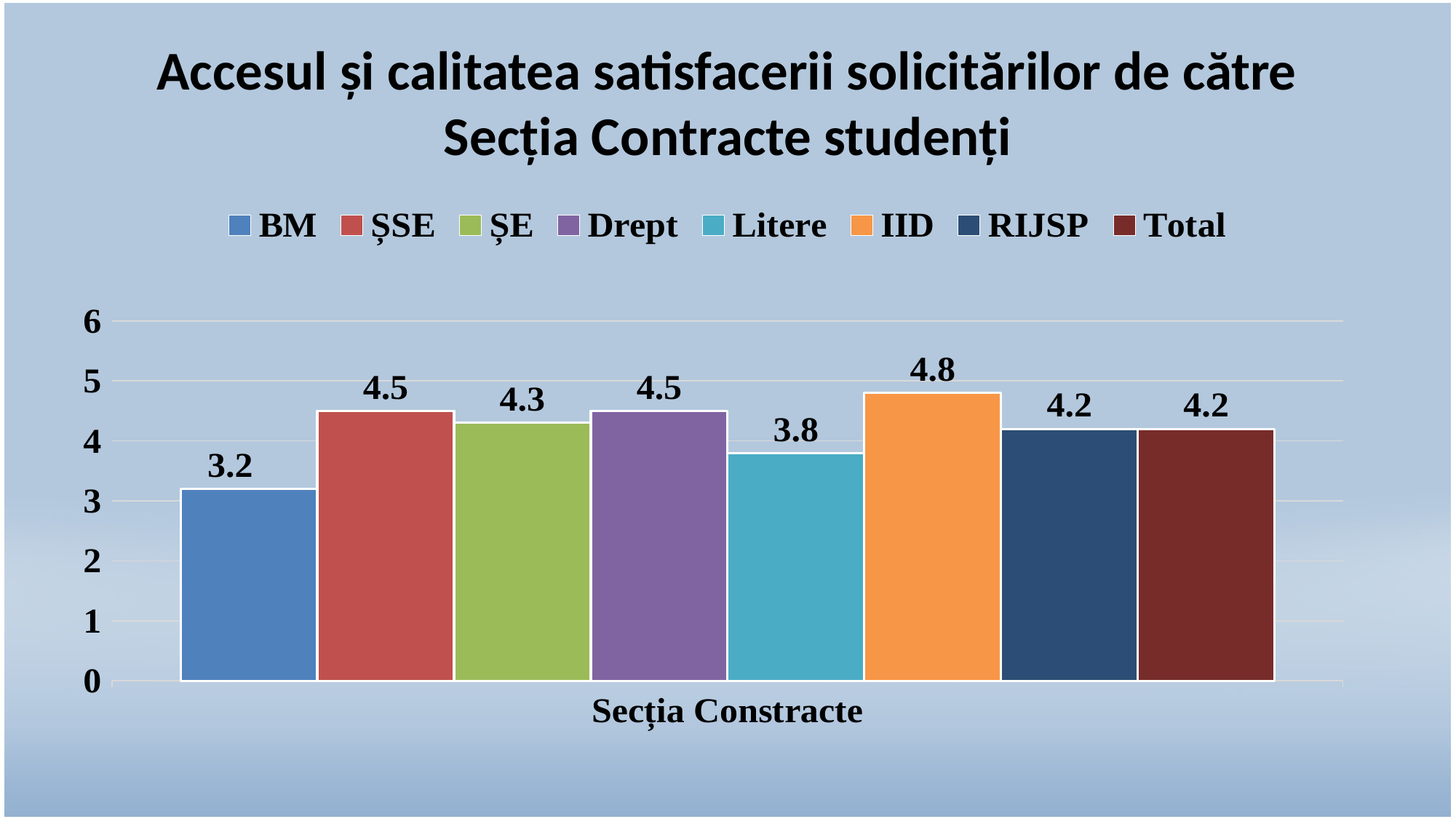
What is the value for IID? 4.8 Which series has the lowest value? BM What is the label on the x axis of the chart? Secția Constracte What is the value for Litere? 3.8 Which series has the highest value? IID What kind of chart is shown on the slide? Bar chart What is the difference between the values for IID and BM? 1.6 What is the value for BM? 3.2 Is the value for RIJSP greater or less than 4? greater What is the value for Total? 4.2 How many series does the legend list? 8 Which is larger, the value for ȘE or the value for Litere? ȘE